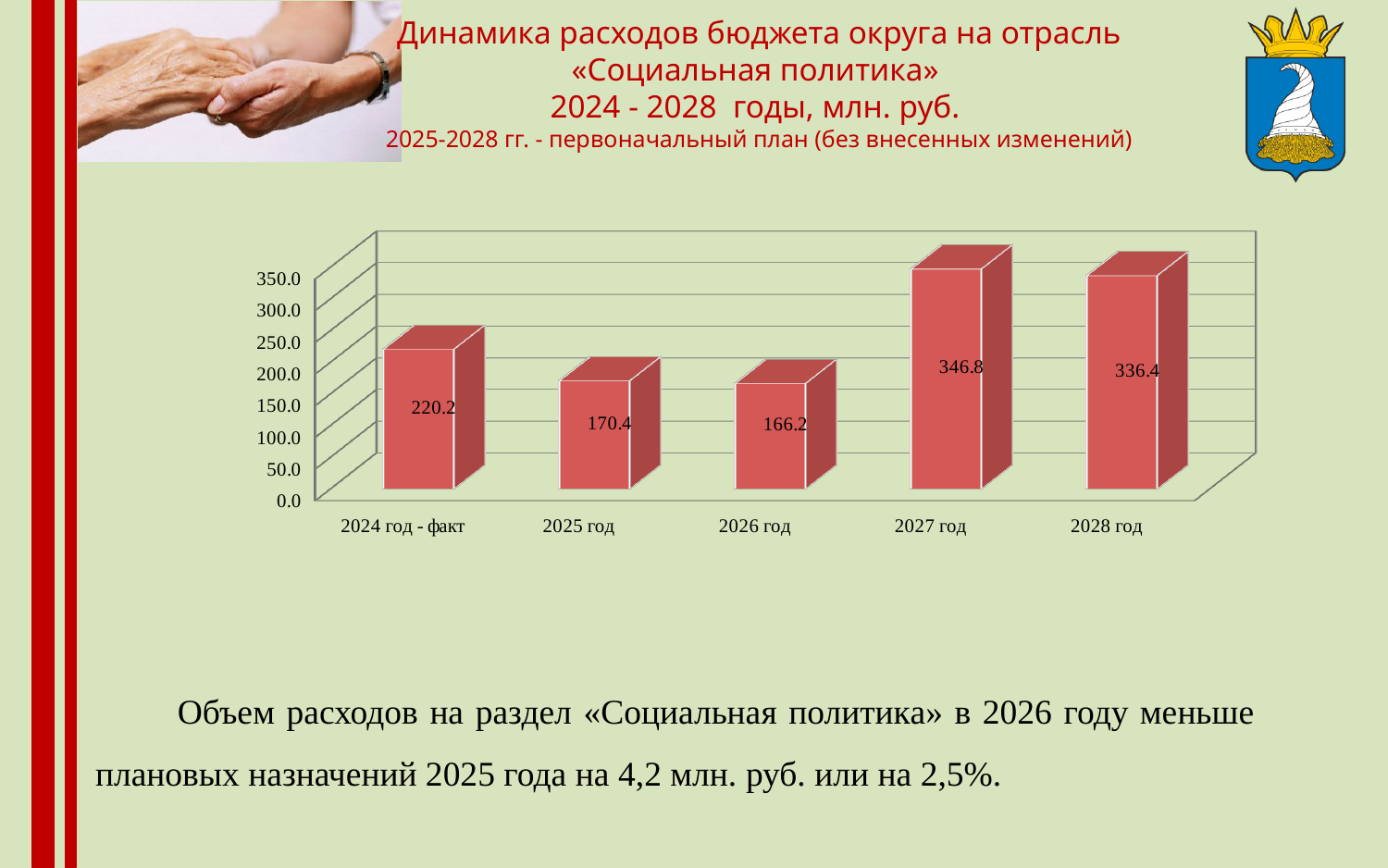
What kind of chart is shown on the slide? bar chart What is the value for 2027 год? 346.8 What is the highest value shown on the vertical axis? 350.0 What is the value for 2024 год - факт? 220.2 Is the value for 2028 год greater or less than 300.0? greater What is the difference between the values for 2025 год and 2026 год? 4.2 What is the difference between the values for 2027 год and 2028 год? 10.4 Which year has the highest value? 2027 год Which is larger, the value for 2024 год - факт or the value for 2025 год? 2024 год - факт How many bars are shown in the chart? 5 What is the value for 2026 год? 166.2 Which year has the lowest value? 2026 год